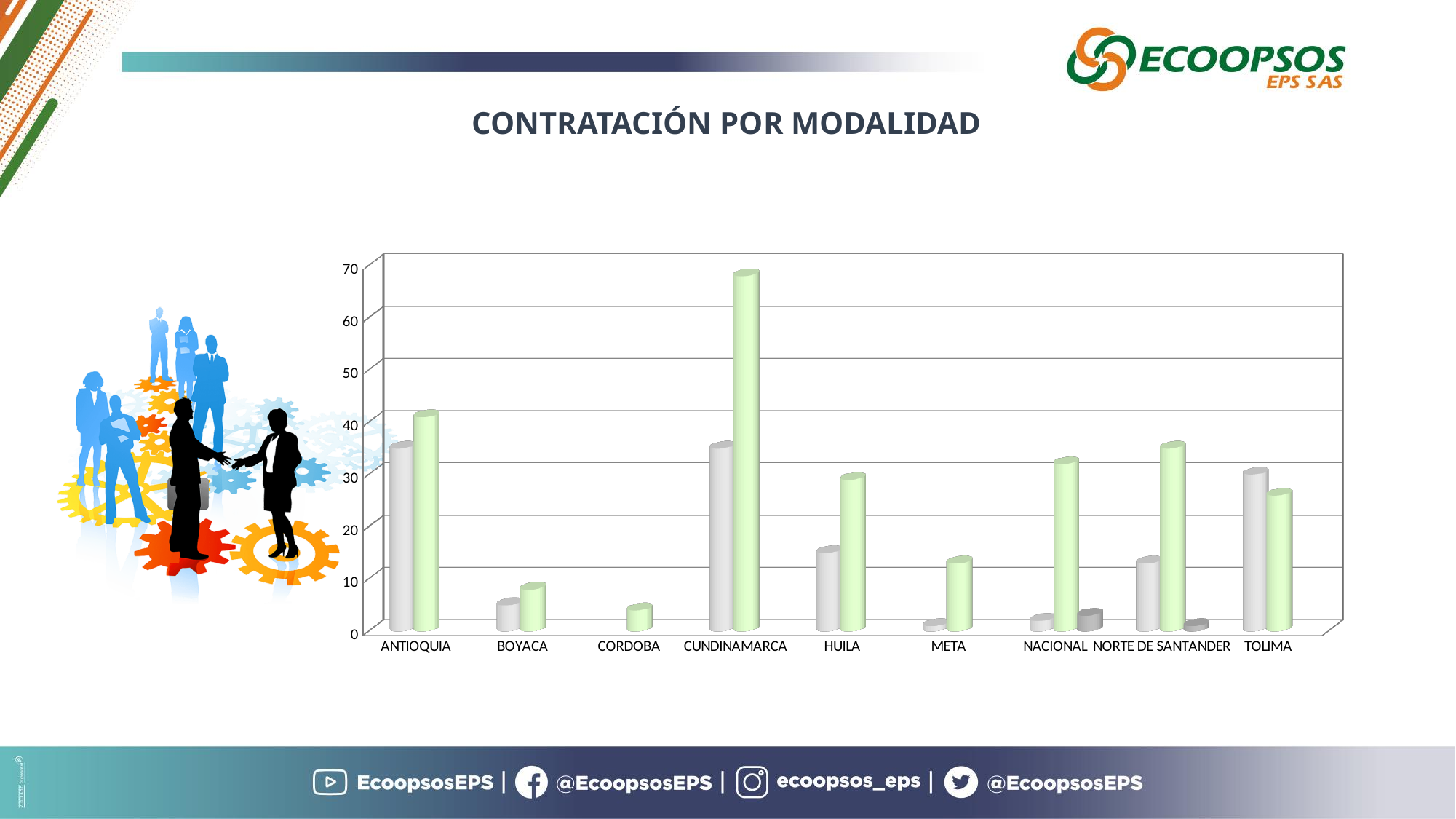
Is the light green bar for CUNDINAMARCA greater or less than 60? greater Which has the taller light green bar, ANTIOQUIA or TOLIMA? ANTIOQUIA Which category has the shortest light green bar? CORDOBA Which has the taller grey bar, ANTIOQUIA or BOYACA? ANTIOQUIA Which category has the tallest bar in the chart? CUNDINAMARCA What is the title of the chart? CONTRATACIÓN POR MODALIDAD Is the light green bar for TOLIMA greater or less than 30? less Is the light green bar for META greater or less than 10? greater How many categories are shown on the x axis of the chart? 9 What kind of chart is shown on the slide? bar chart